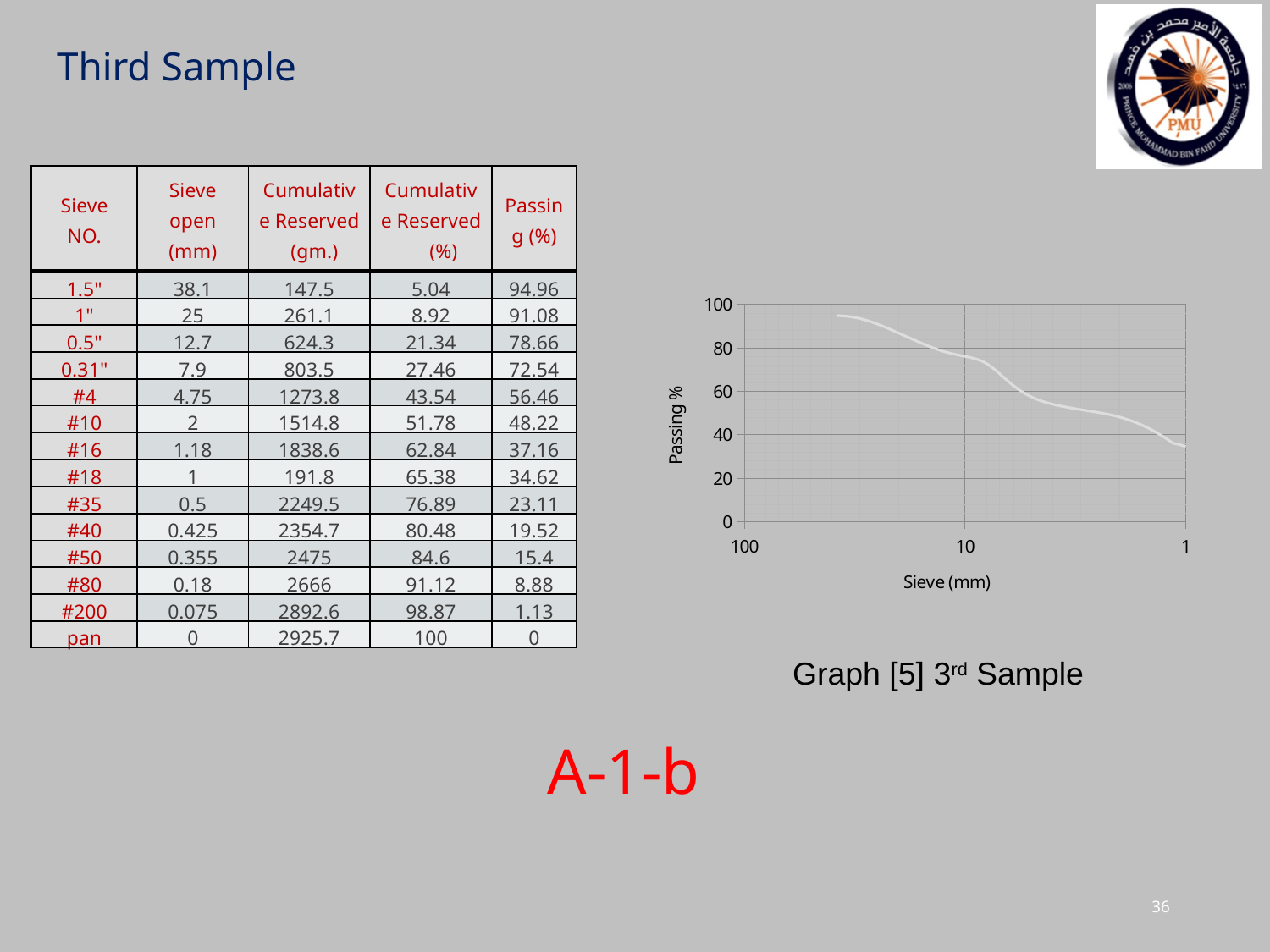
In Graph [5] 3rd Sample, is the passing value at the right end of the line (sieve size 1 mm) greater or less than 60? less In Graph [5] 3rd Sample, is the passing value at a sieve size of 10 mm greater or less than 60? greater In Graph [5] 3rd Sample, is the passing value at a sieve size of 1 mm greater or less than 20? greater What is the y-axis title of Graph [5] 3rd Sample? Passing % In Graph [5] 3rd Sample, does the line rise or fall from left to right? fall What is the x-axis title of Graph [5] 3rd Sample? Sieve (mm) What kind of chart is Graph [5] 3rd Sample? line chart